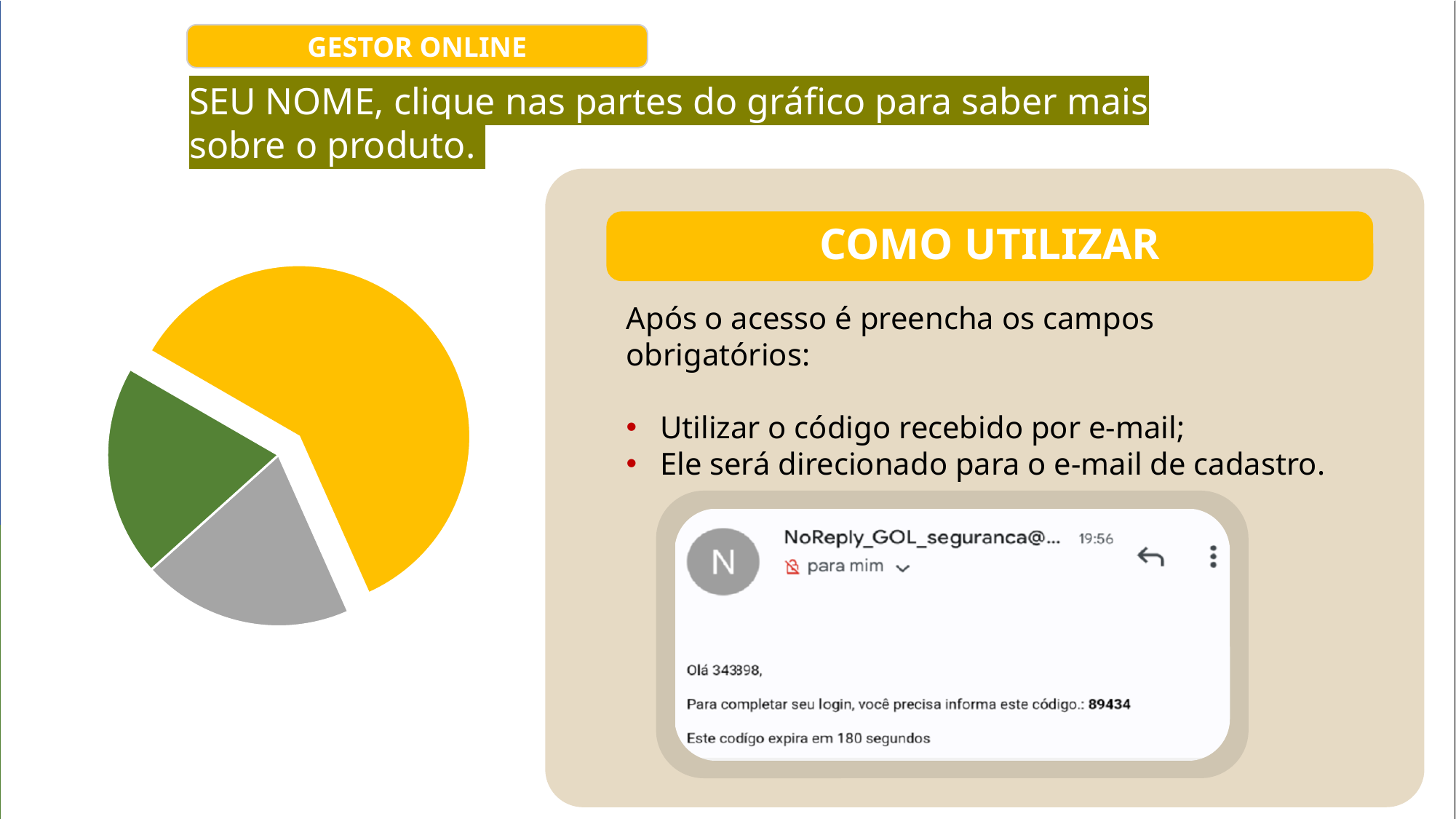
How many slices does the pie chart have? 3 Is the yellow slice of the pie chart greater or less than half of the pie? greater Which colour slice of the pie chart is the largest? yellow Which is larger in the pie chart, the yellow slice or the gray slice? yellow Does the pie chart show data labels with values on its slices? No What kind of chart is shown on the left of the slide? pie chart Which is larger in the pie chart, the yellow slice or the green slice? yellow Does the pie chart display a legend? No